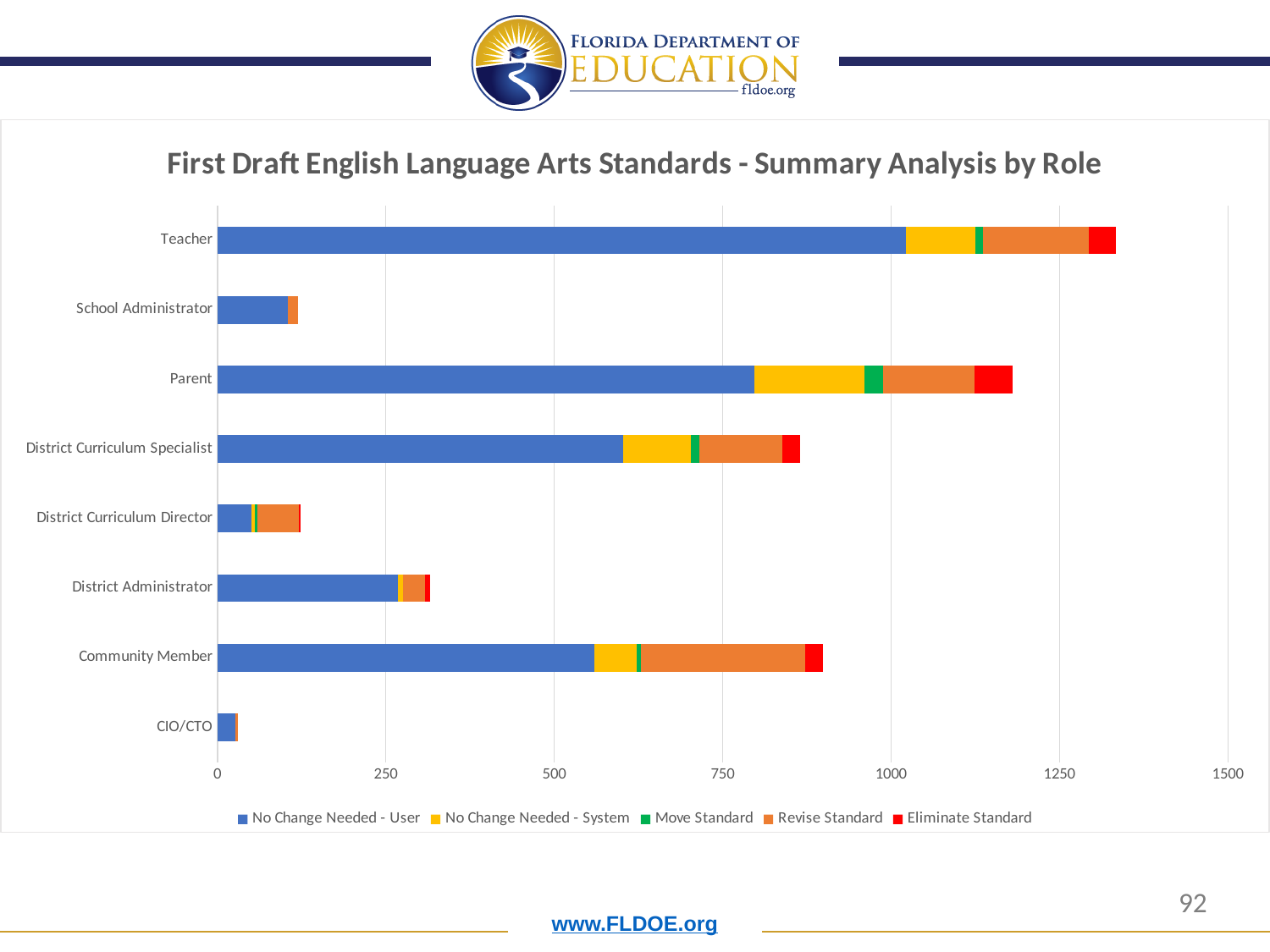
Which role has the longest total bar? Teacher Is the total bar for Teacher greater or less than 1250? greater Is the total bar for Community Member greater or less than 1000? less Which series is shown in red in the legend? Eliminate Standard Is the total bar for Parent greater or less than 1000? greater Which has the longer total bar, Parent or Community Member? Parent How many roles (categories) are plotted on the chart? 8 What kind of chart is shown on the slide? Stacked bar chart Which role has the shortest total bar? CIO/CTO How many series does the legend list? 5 What is the title of the chart? First Draft English Language Arts Standards - Summary Analysis by Role